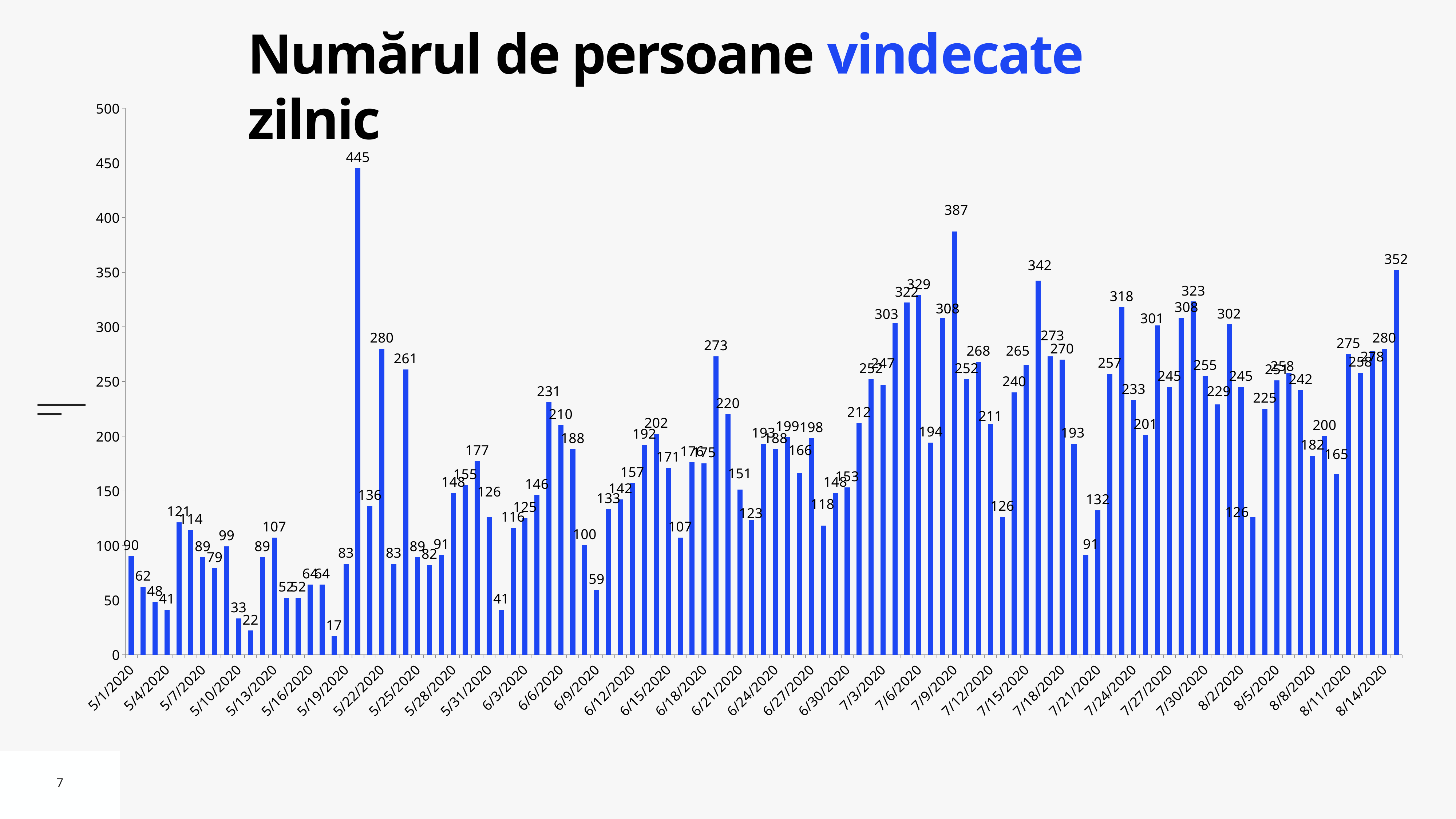
What is the value for 7/9/2020? 387 What is the value for 7/6/2020? 329 What kind of chart is shown on the slide? bar chart Which date has the larger value, 7/9/2020 or 7/6/2020? 7/9/2020 What is the value for 5/10/2020? 33 What is the highest value shown in the chart? 445 What is the value for 6/9/2020? 59 What is the title of the chart? Numărul de persoane vindecate zilnic What is the lowest value shown in the chart? 17 Is the value for 8/14/2020 greater or less than 250? greater What is the difference between the values for 7/9/2020 and 7/6/2020? 58 Do the values generally rise or fall from May to August along the x axis? rise